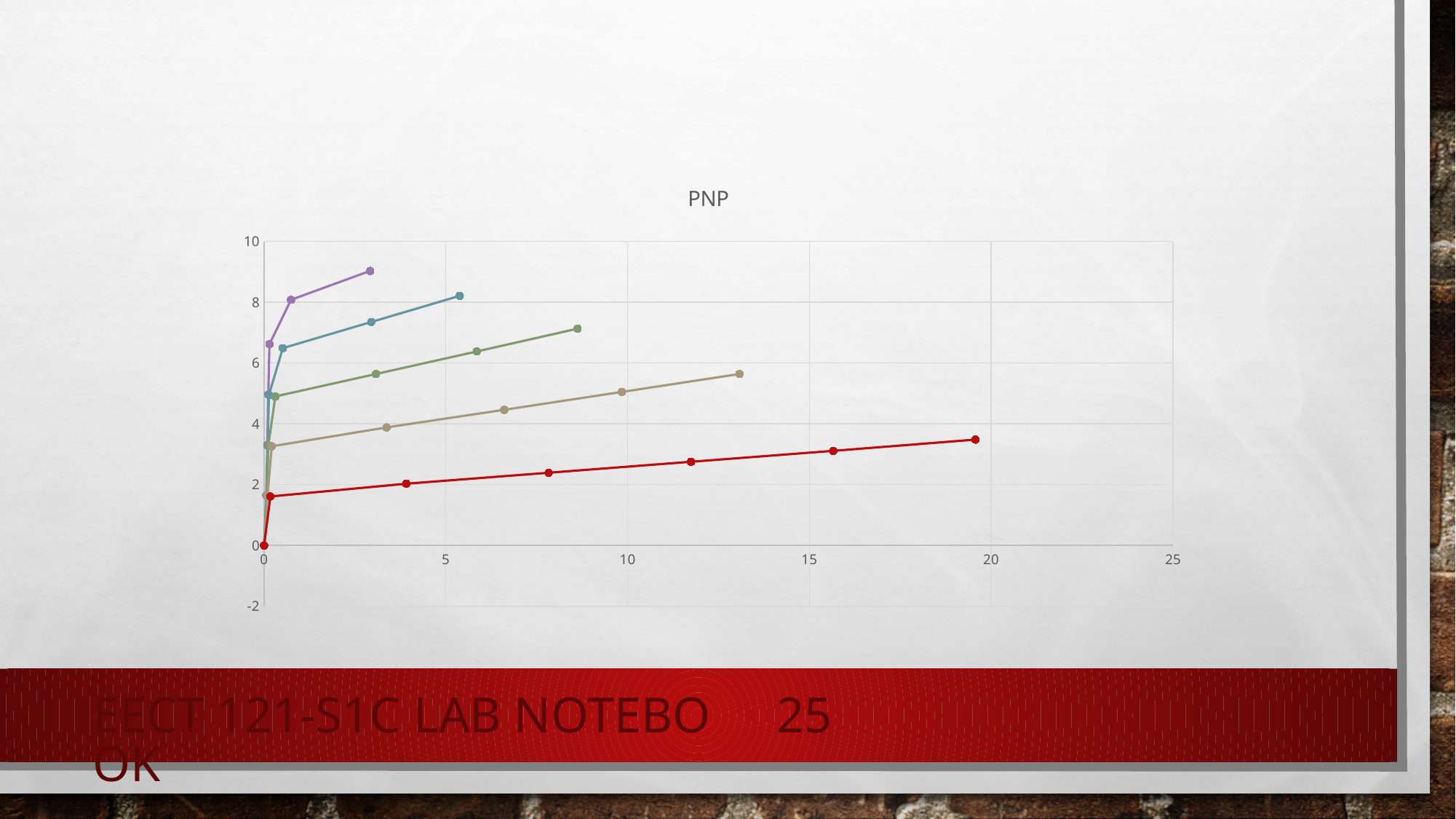
Do the values of the red line rise or fall as the horizontal axis increases? rise What is the maximum value shown on the horizontal axis? 25 Is the highest point of the purple line greater or less than 8 on the vertical axis? greater What is the title of the chart? PNP Is the rightmost point of the red line greater or less than 15 on the horizontal axis? greater Is the rightmost point of the red line greater or less than 4 on the vertical axis? less Which coloured line reaches the highest value on the vertical axis? purple Which coloured line extends farthest along the horizontal axis? red How many lines (series) are plotted on the chart? 5 What kind of chart is shown on the slide? line chart Which line reaches a higher vertical value at its rightmost point, the teal line or the green line? teal